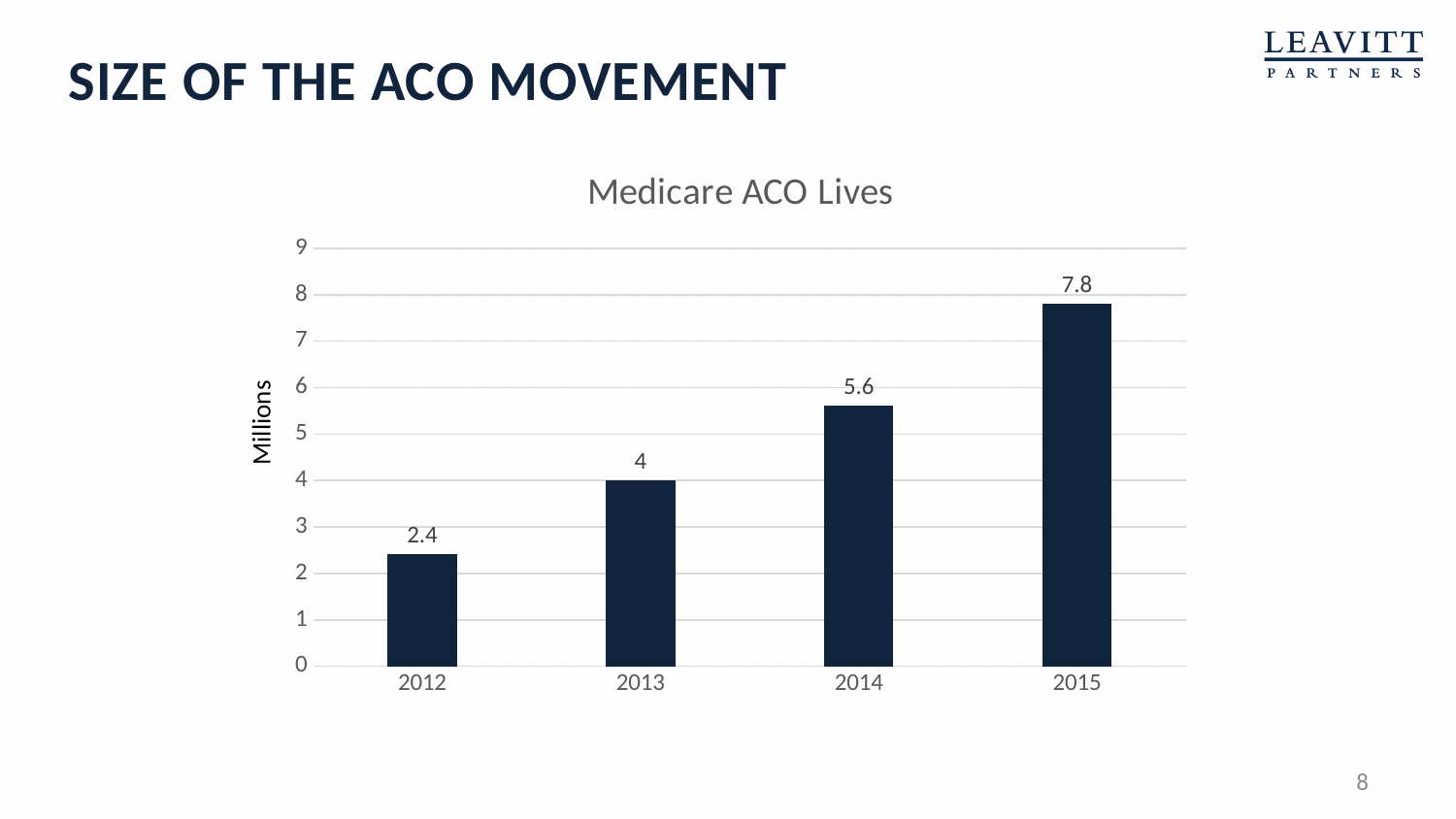
Which is larger in the Medicare ACO Lives chart, the value for 2013 or the value for 2014? 2014 Which year has the lowest value in the Medicare ACO Lives chart? 2012 What is the value for 2015 in the Medicare ACO Lives chart? 7.8 Is the value for 2013 greater or less than 3 in the Medicare ACO Lives chart? greater Do the values in the Medicare ACO Lives chart rise or fall from 2012 to 2015? rise What is the value for 2012 in the Medicare ACO Lives chart? 2.4 Which year has the highest value in the Medicare ACO Lives chart? 2015 What is the difference between the 2014 and 2013 values in the Medicare ACO Lives chart? 1.6 How many years are shown on the x axis of the Medicare ACO Lives chart? 4 What kind of chart is used to show Medicare ACO Lives? bar chart What is the difference between the 2015 and 2012 values in the Medicare ACO Lives chart? 5.4 What is the value for 2014 in the Medicare ACO Lives chart? 5.6